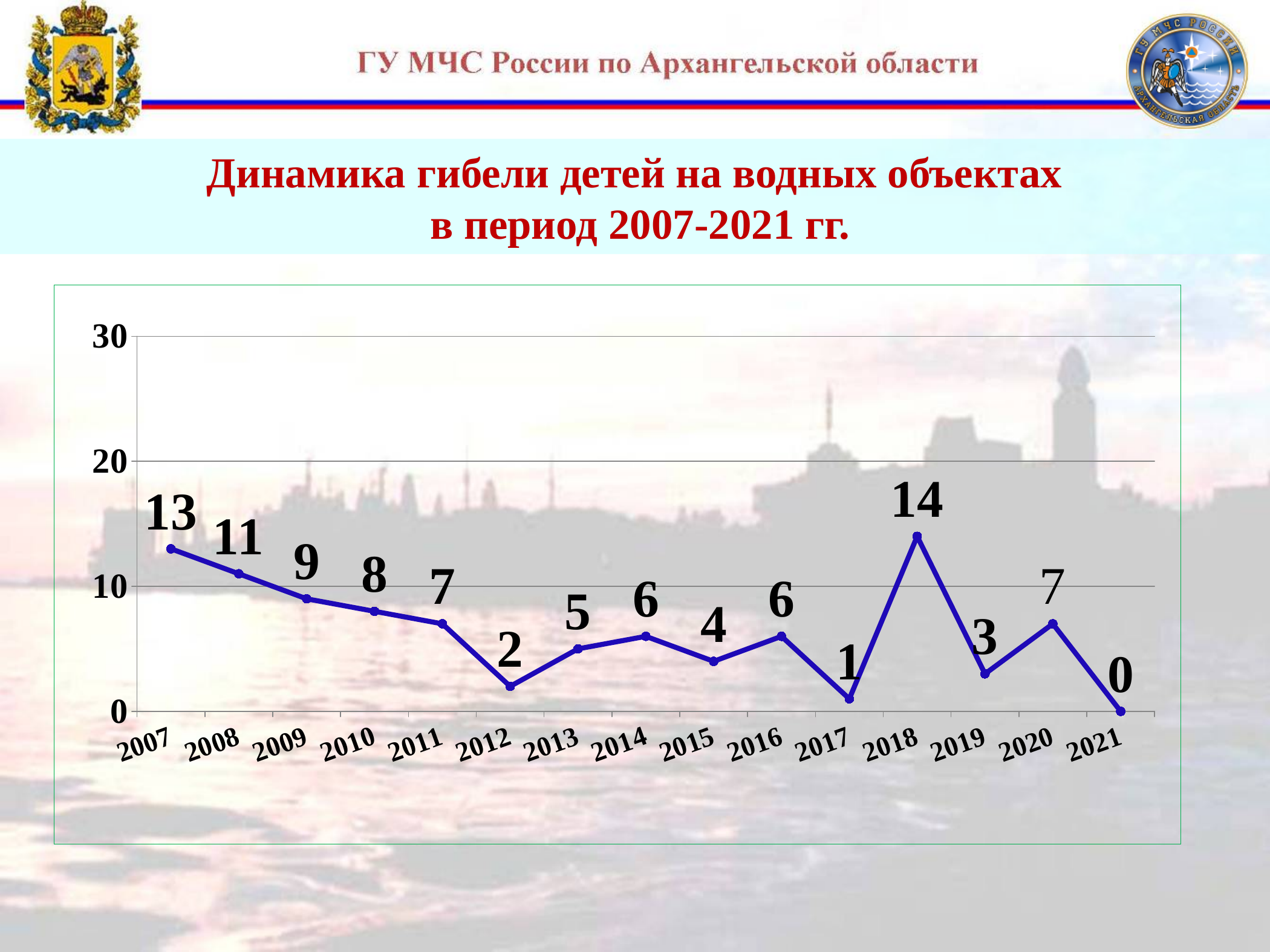
Do the values rise or fall from 2007 to 2012? fall What kind of chart is shown on the slide? line chart Which is larger, the value for 2009 or the value for 2020? 2009 What is the difference between the values for 2018 and 2017? 13 What is the value for 2021? 0 What is the value for 2007? 13 What is the value for 2018? 14 Which year has the lowest value? 2021 What is the value for 2012? 2 How many years are plotted on the chart? 15 Is the value for 2008 greater or less than 10? greater Which year has the highest value? 2018